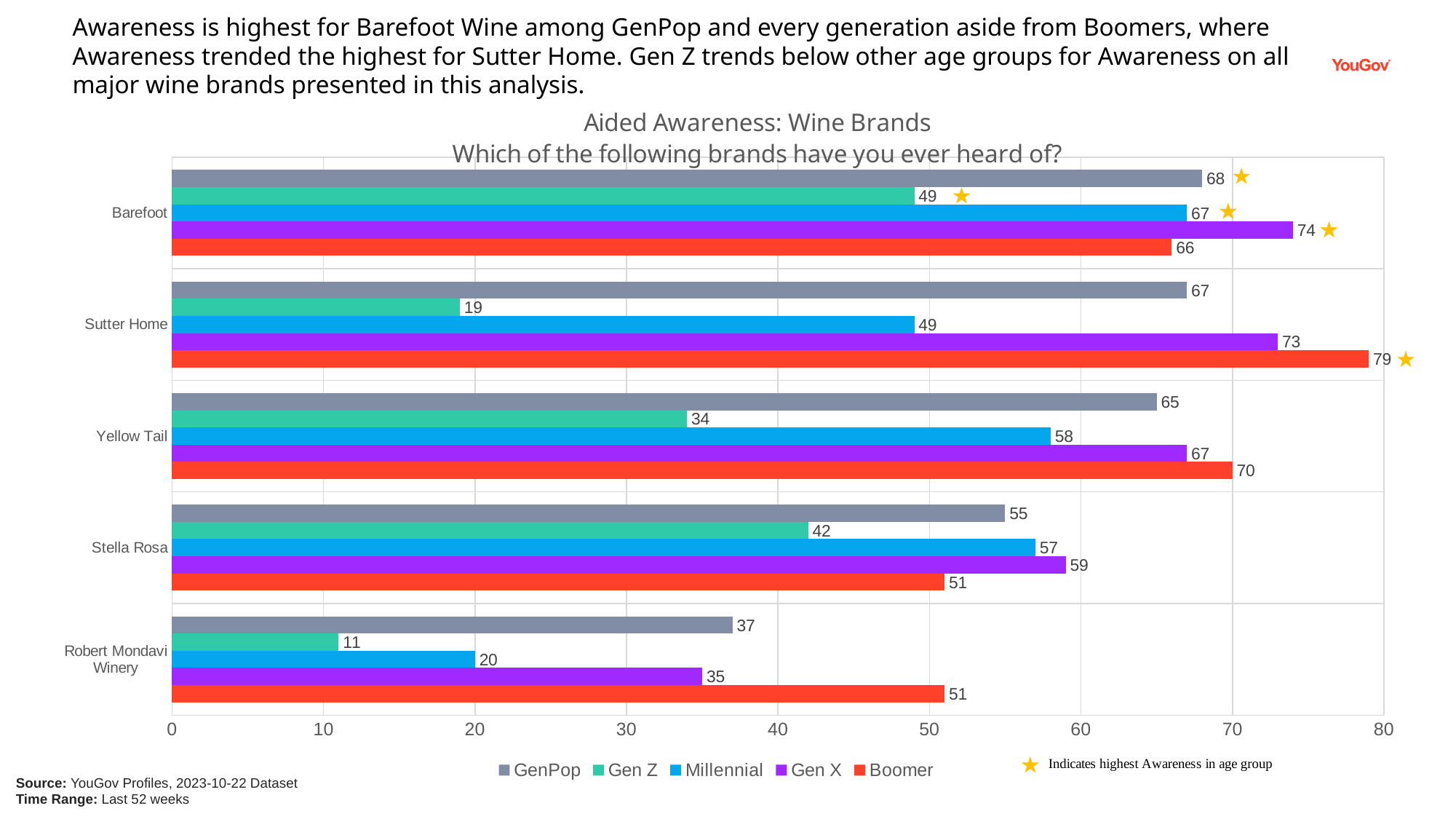
What is the title of the chart? Aided Awareness: Wine Brands What is the difference between the Boomer and Gen Z awareness values for Sutter Home? 60 Which brand has the highest Gen Z awareness? Barefoot What is the Gen Z awareness value for Robert Mondavi Winery? 11 What is the GenPop awareness value for Barefoot? 68 How many series does the legend list? 5 What is the Boomer awareness value for Sutter Home? 79 What kind of chart is shown on the slide? Bar chart How many wine brands are shown on the chart? 5 Which is larger for Yellow Tail: the Gen X value or the Millennial value? Gen X Which brand has the lowest Millennial awareness? Robert Mondavi Winery What does the star symbol on the chart indicate? Highest Awareness in age group